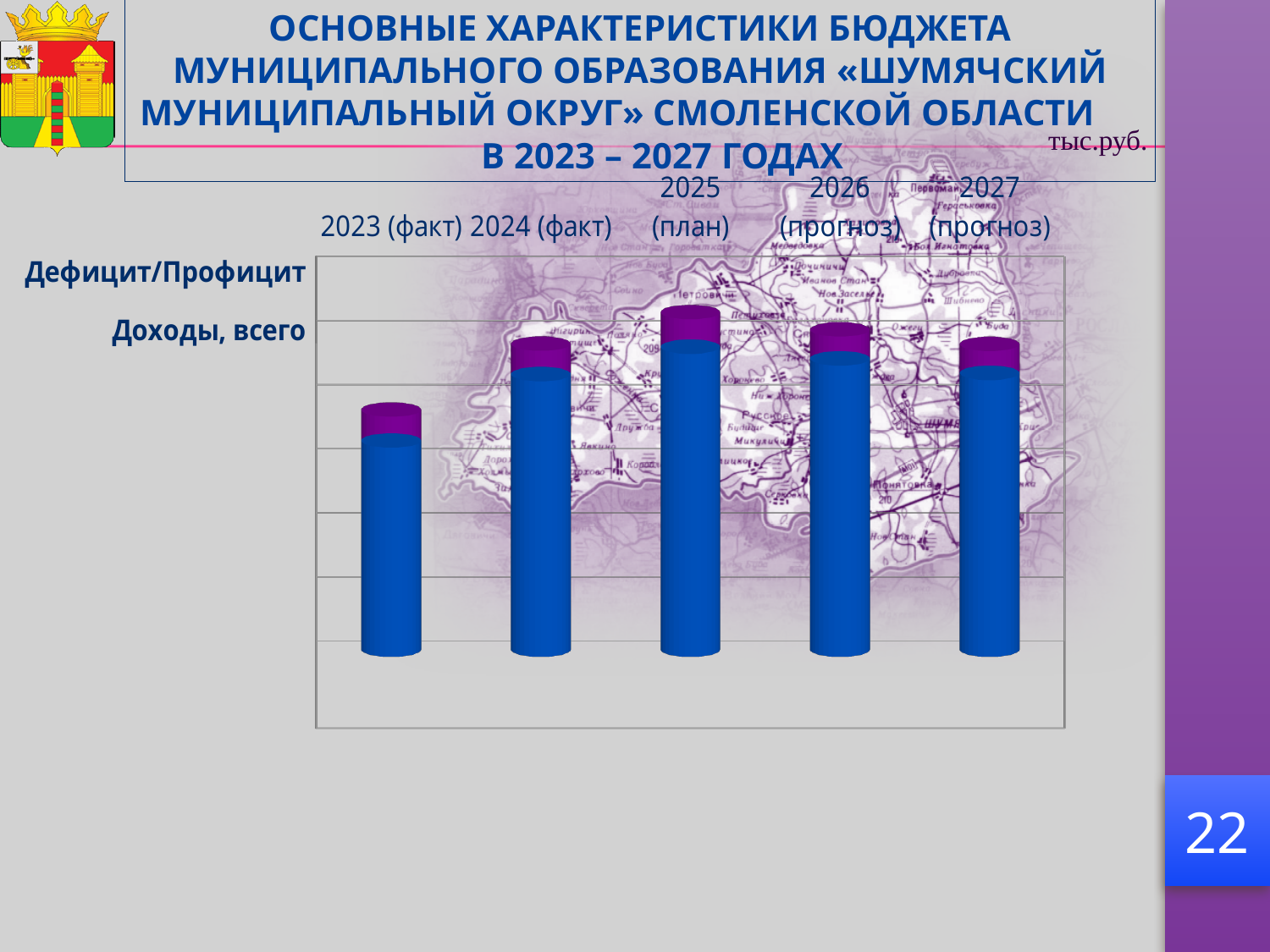
Which bar is taller, 2025 (план) or 2027 (прогноз)? 2025 (план) How many year categories are plotted on the chart? 5 Do the bars rise or fall from 2025 (план) to 2027 (прогноз)? fall In what units are the chart values given, according to the slide? тыс.руб. Which bar is taller, 2024 (факт) or 2025 (план)? 2025 (план) What kind of chart is shown on the slide? bar chart What are the two series named on the chart? Дефицит/Профицит and Доходы, всего Which bar is taller, 2023 (факт) or 2026 (прогноз)? 2026 (прогноз) Which year has the shortest bar on the chart? 2023 (факт) Do the bars rise or fall from 2023 (факт) to 2025 (план)? rise Which year has the tallest bar on the chart? 2025 (план)